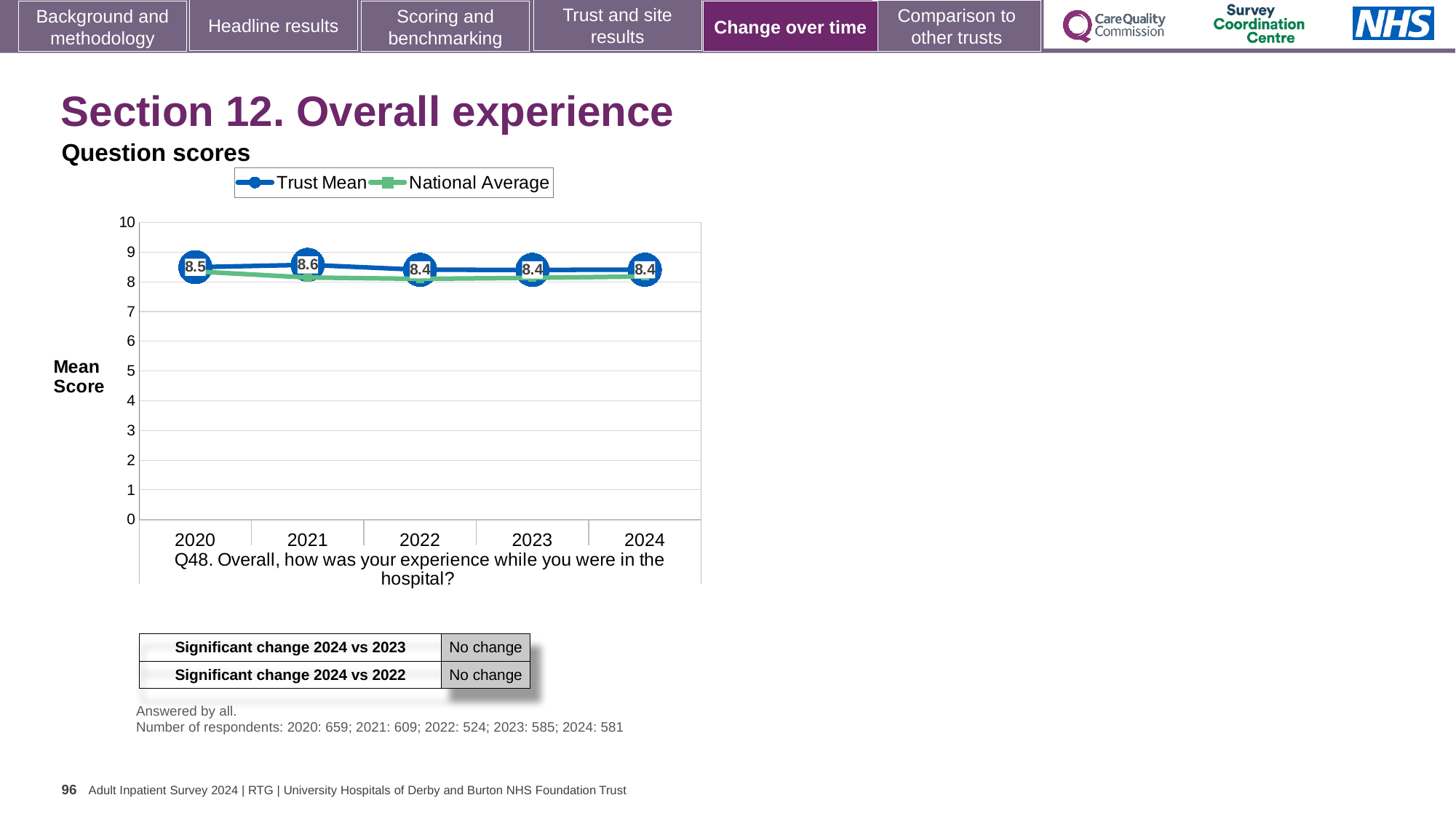
What is the Trust Mean score for 2021? 8.6 Which is larger, the Trust Mean score for 2021 or for 2022? 2021 What is the label on the y axis of the chart? Mean Score What is the difference between the Trust Mean scores for 2021 and 2020? 0.1 What is the Trust Mean score for 2020? 8.5 How many years are shown on the x axis? 5 How many series does the legend list? 2 What is the Trust Mean score for 2024? 8.4 Does the Trust Mean score rise or fall from 2021 to 2022? fall In which year is the Trust Mean score highest? 2021 Is the National Average value for 2020 greater or less than 7? greater What kind of chart is shown? line chart